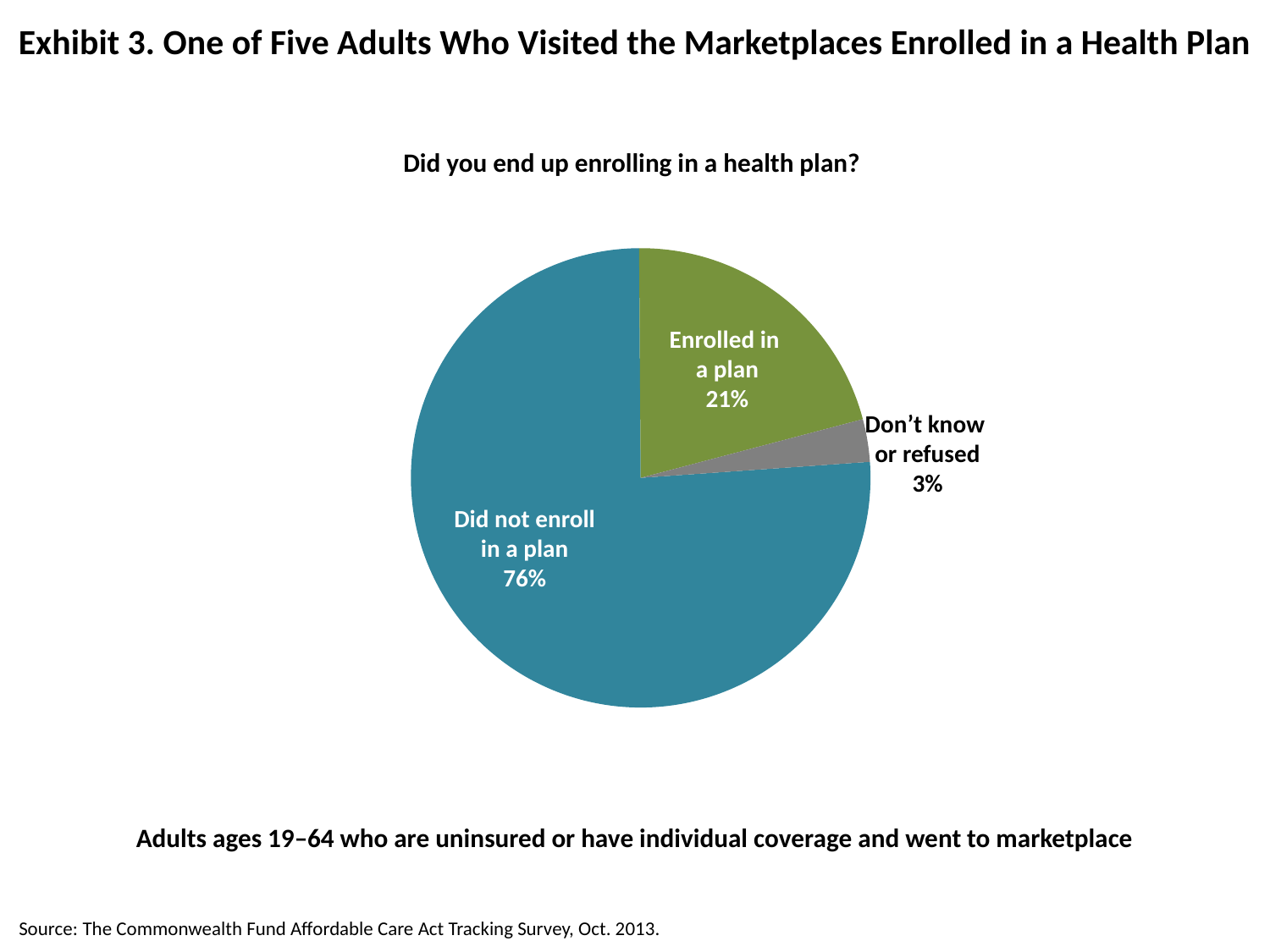
What is the difference in percentage points between 'Did not enroll in a plan' and 'Enrolled in a plan'? 55 What percentage of adults enrolled in a plan? 21% What percentage of adults answered 'Don't know or refused'? 3% What share of the pie does the 'Enrolled in a plan' slice represent? 21% What question is shown as the chart's title? Did you end up enrolling in a health plan? How many slices does the pie chart have? 3 Which is larger: the share for 'Enrolled in a plan' or the share for 'Don't know or refused'? Enrolled in a plan What kind of chart is shown on the slide? pie chart Which response has the largest share of the pie? Did not enroll in a plan Which response has the smallest share of the pie? Don't know or refused What colour is the 'Enrolled in a plan' slice? green What percentage of adults did not enroll in a plan? 76%